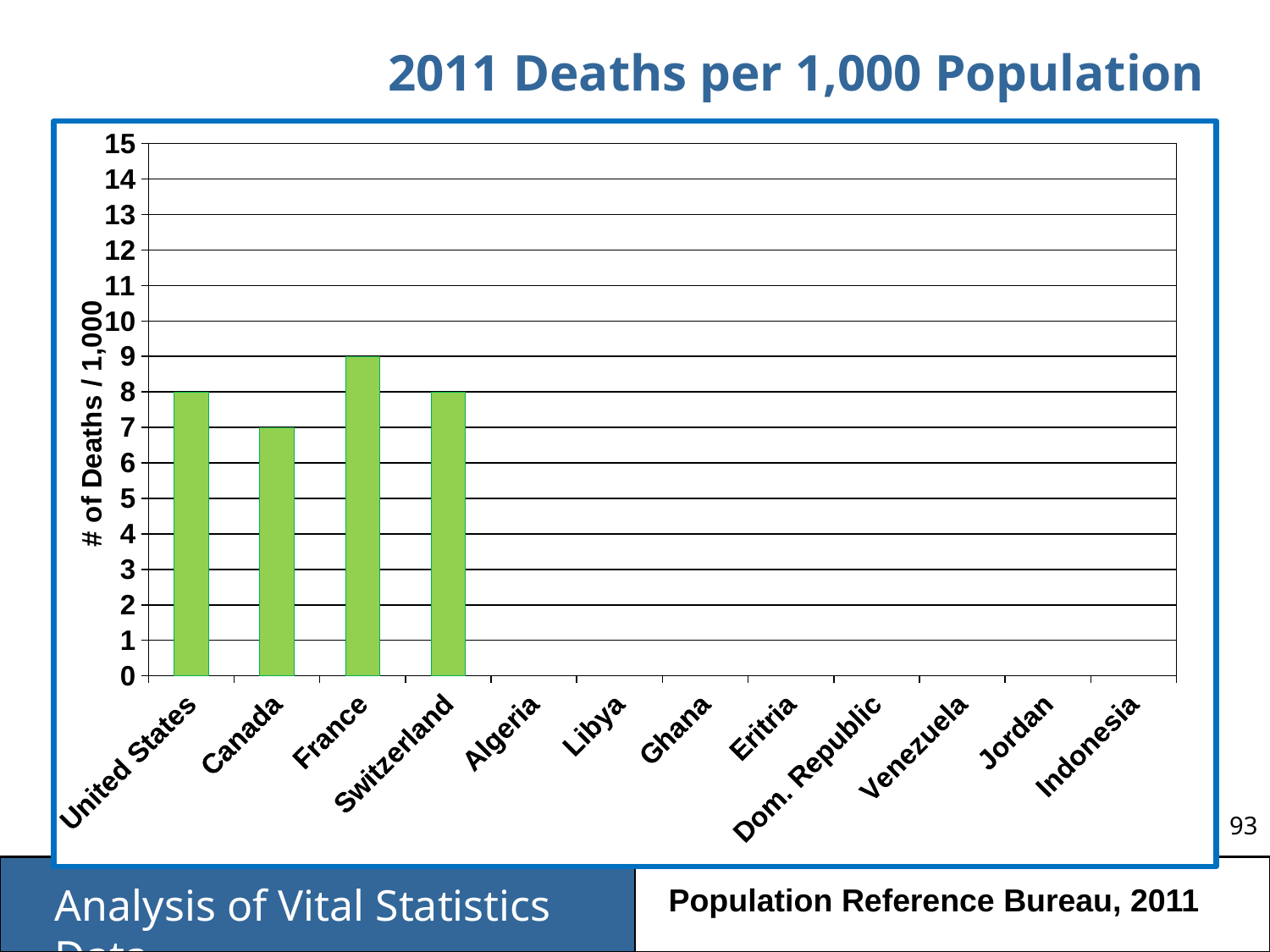
Which is larger, the value for France or the value for Switzerland? France What is the value for the United States? 8 Which country has the lowest plotted value among the bars shown? Canada How many country labels are shown on the x axis? 12 What is the difference between the values for France and Canada? 2 What is the title of the chart? 2011 Deaths per 1,000 Population What is the value for Switzerland? 8 Is the value for Canada greater or less than 10? less What kind of chart is shown? bar chart What is the value for France? 9 Which country has the highest plotted value? France What is the value for Canada? 7